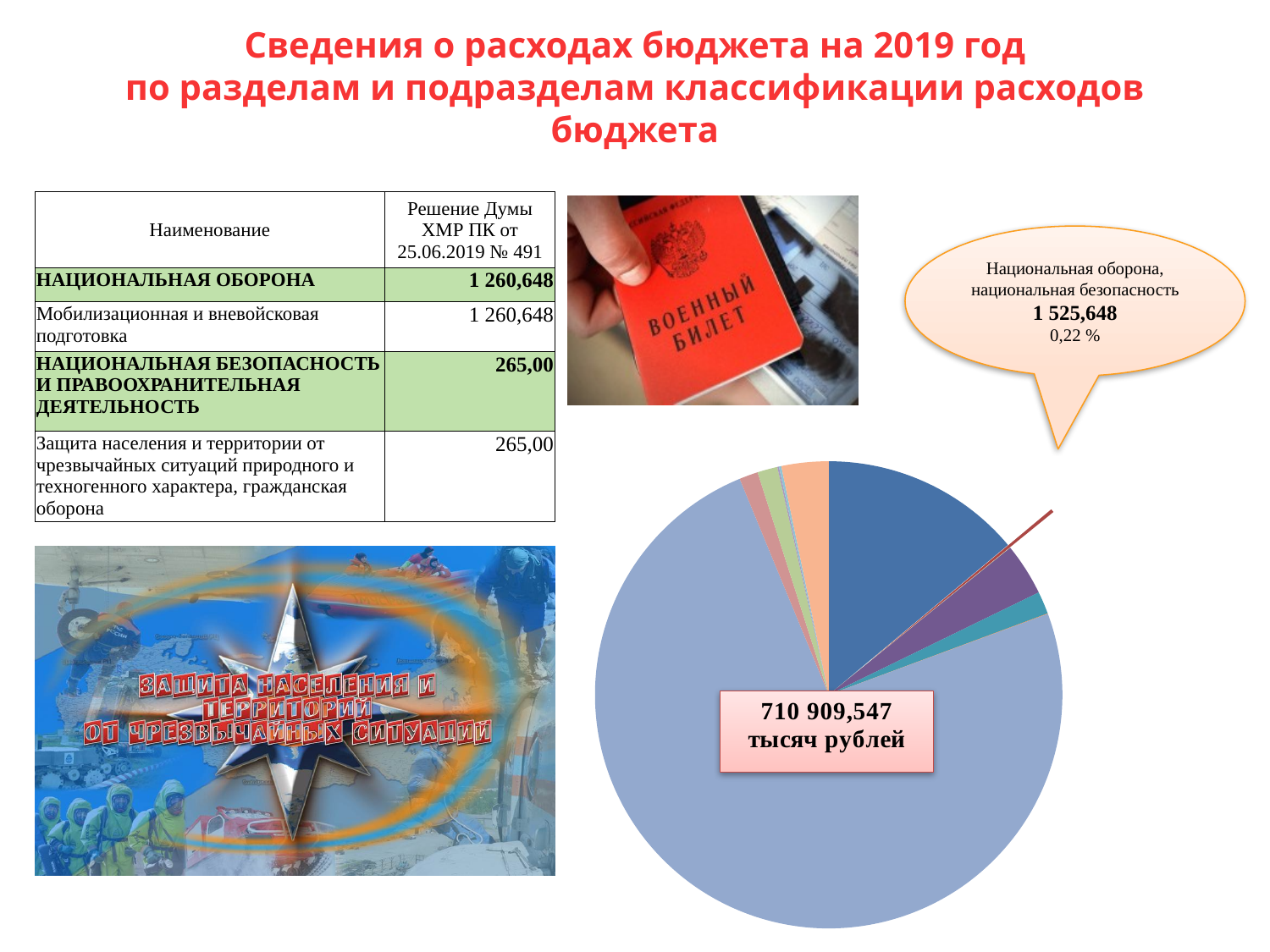
What share of the pie does the callout give for "Национальная оборона, национальная безопасность"? 0,22 % Is the share for "Национальная оборона, национальная безопасность" greater or less than 1 %? less What kind of chart is shown on the slide? pie chart What value does the callout give for "Национальная оборона, национальная безопасность" in the pie chart? 1 525,648 What total amount is printed in the box at the centre of the pie chart? 710 909,547 тысяч рублей Does the pie chart have a legend? No What colour is the largest slice of the pie chart? light blue